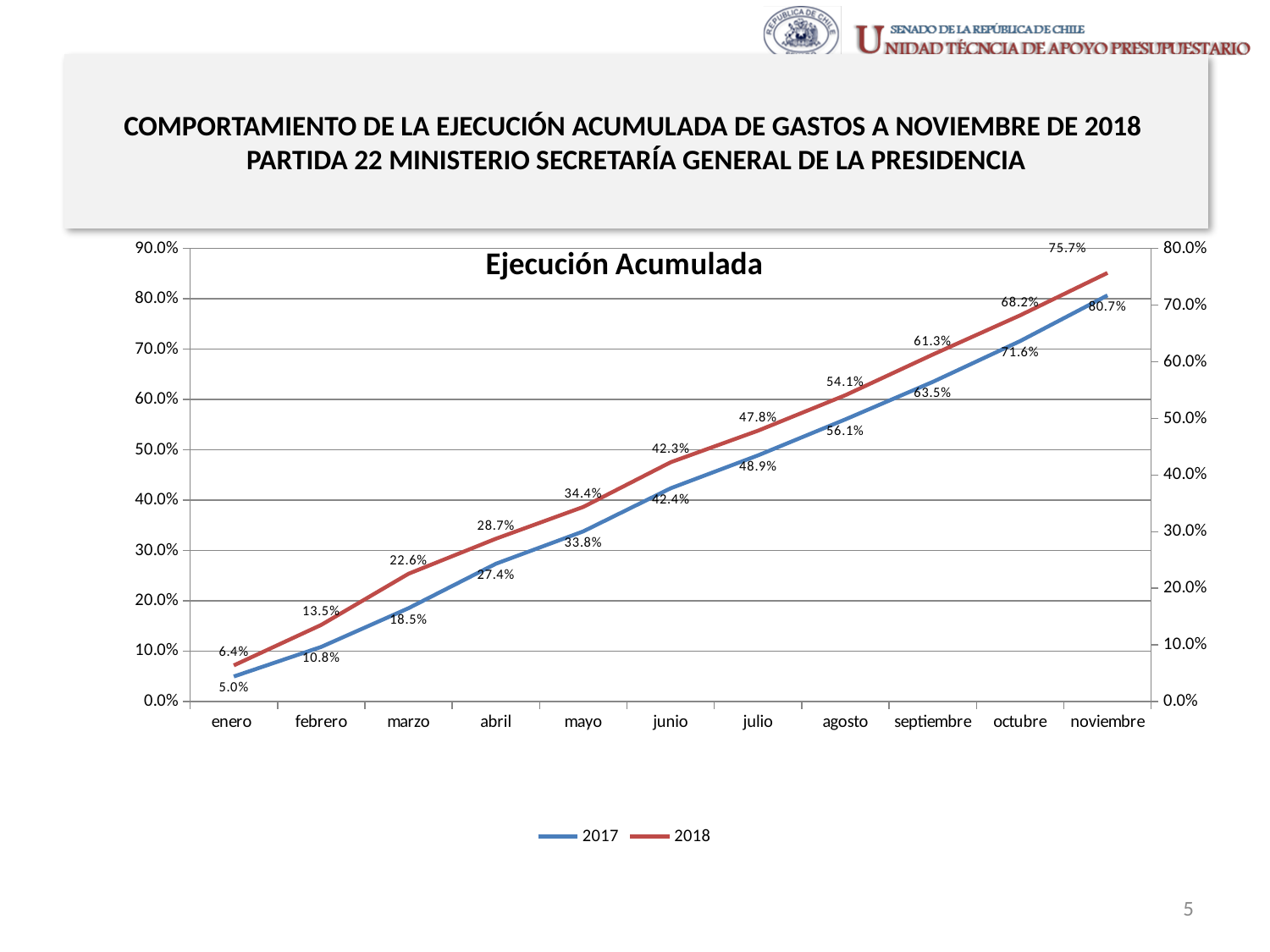
In which month is the 2017 series lowest? enero Does the 2017 series rise or fall from enero to noviembre? rise What is the value for 2018 in marzo? 22.6% In which month is the 2018 series highest? noviembre What type of chart is shown on the slide? line chart How many series does the legend list? 2 How many months are plotted along the x axis? 11 What is the difference between the 2017 and 2018 values in noviembre? 5.0% What is the value for 2017 in junio? 42.4% What is the value for 2018 in noviembre? 75.7% Which is larger, the 2017 value in agosto or the 2018 value in agosto? 2017 (56.1%) What is the value for 2017 in noviembre? 80.7%